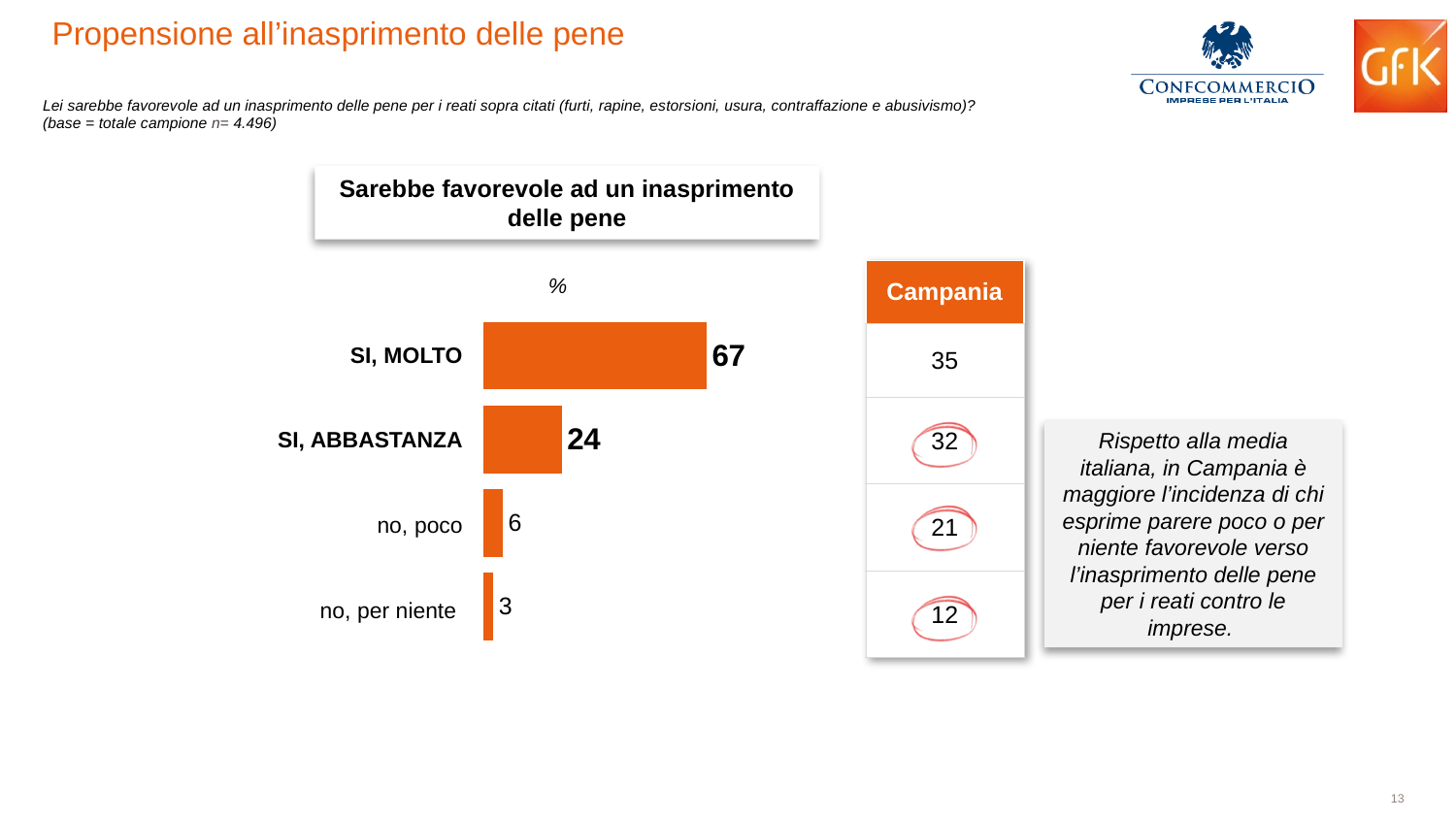
What is the value for "SI, ABBASTANZA" in the chart? 24 What is the title of the chart? Sarebbe favorevole ad un inasprimento delle pene Which category has the lowest value in the chart? no, per niente How many categories are shown in the chart? 4 What kind of chart is shown on the slide? bar chart What is the difference between the values for "no, poco" and "no, per niente"? 3 What is the difference between the values for "SI, MOLTO" and "SI, ABBASTANZA"? 43 What is the value for "no, per niente" in the chart? 3 What is the value for "SI, MOLTO" in the chart? 67 Which is larger, the value for "SI, ABBASTANZA" or the value for "no, poco"? SI, ABBASTANZA What is the value for "no, poco" in the chart? 6 Which category has the highest value in the chart? SI, MOLTO